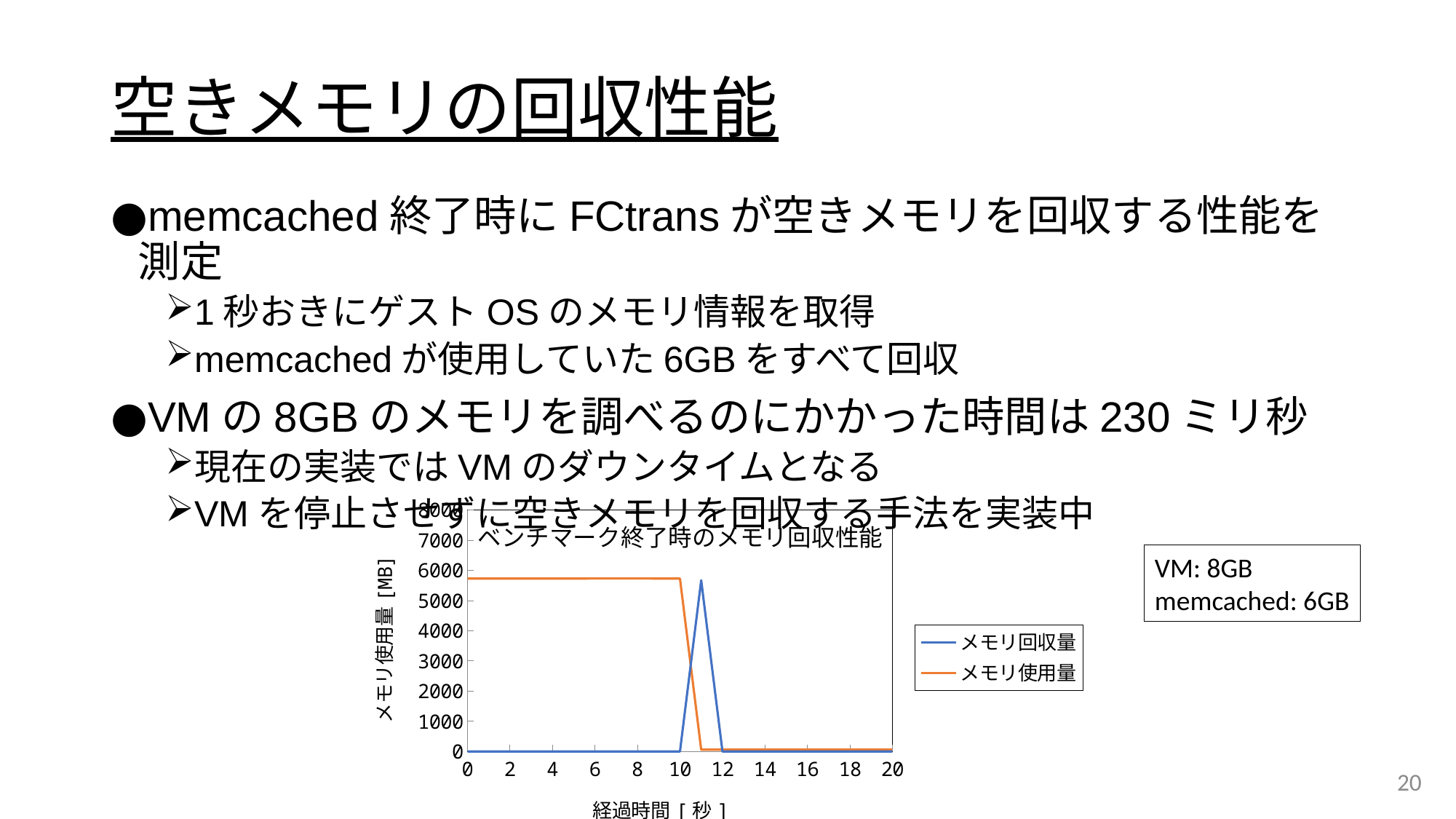
Does the メモリ使用量 series rise or fall between 10 and 12 seconds? fall What are the two series named in the chart's legend? メモリ回収量, メモリ使用量 What kind of chart is shown on the slide? line chart How many series does the chart's legend list? 2 Is the value of メモリ使用量 at 5 seconds greater or less than 5000? greater At what elapsed time does the メモリ回収量 series reach its highest value? 11 At 11 seconds, which series has the larger value, メモリ回収量 or メモリ使用量? メモリ回収量 Is the value of メモリ使用量 at 15 seconds greater or less than 1000? less At 5 seconds, which series has the larger value, メモリ回収量 or メモリ使用量? メモリ使用量 What is the title of the chart? ベンチマーク終了時のメモリ回収性能 Is the value of メモリ回収量 at 5 seconds greater or less than 1000? less